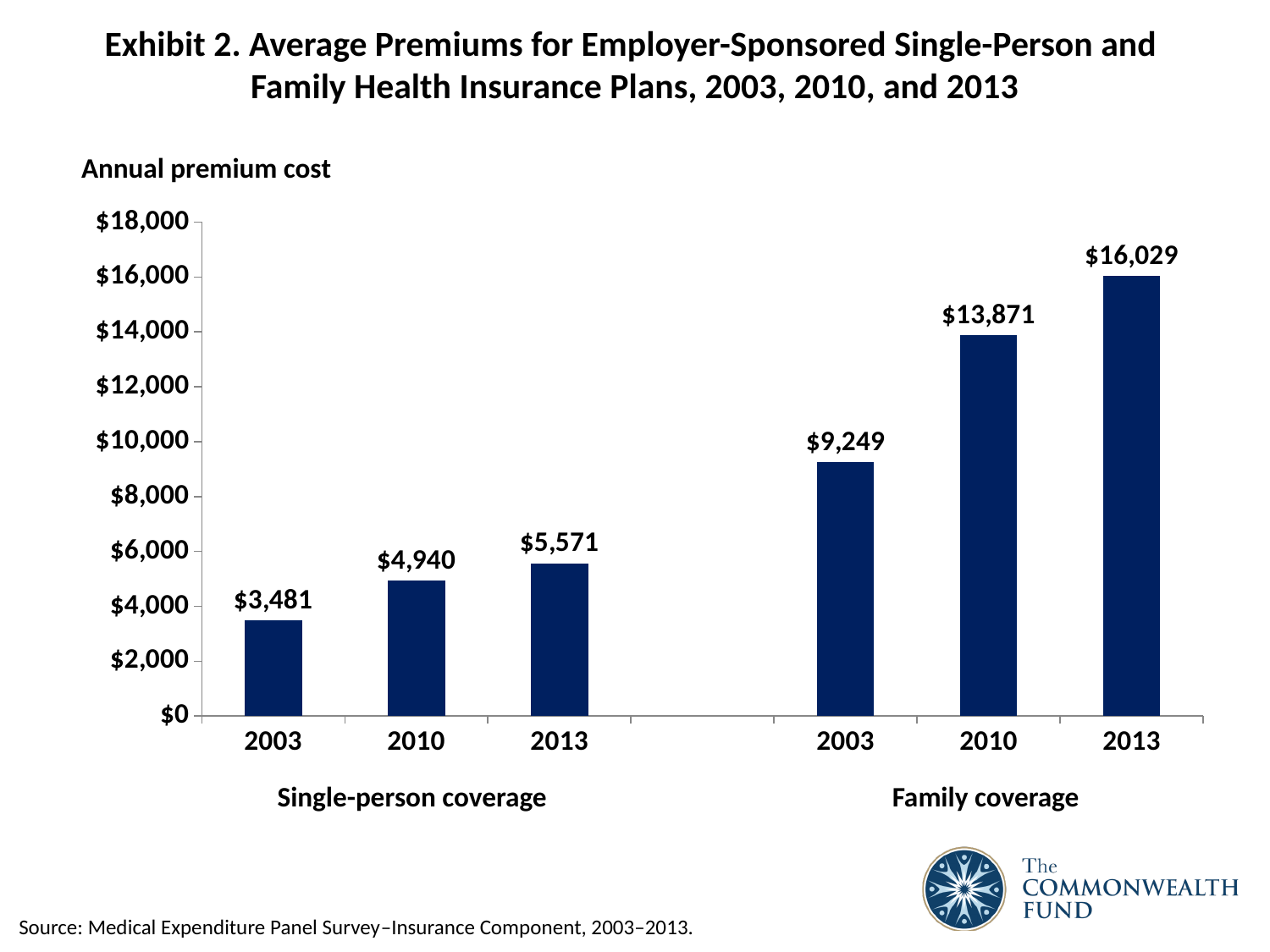
How many bars are plotted on the chart? 6 What was the average annual premium for family coverage in 2013? $16,029 What was the average annual premium for family coverage in 2010? $13,871 What is the difference between the single-person premium in 2013 and in 2010? $631 Which bar shows the lowest annual premium cost? Single-person coverage, 2003 What was the average annual premium for single-person coverage in 2003? $3,481 How much higher was the family coverage premium in 2013 than in 2003? $6,780 What kind of chart is shown on the slide? Bar chart Which bar shows the highest annual premium cost? Family coverage, 2013 Is the family coverage premium in 2010 greater or less than $14,000? less Do the single-person coverage premiums rise or fall from 2003 to 2013? Rise Which is larger: the single-person premium in 2013 or the family premium in 2003? Family premium in 2003